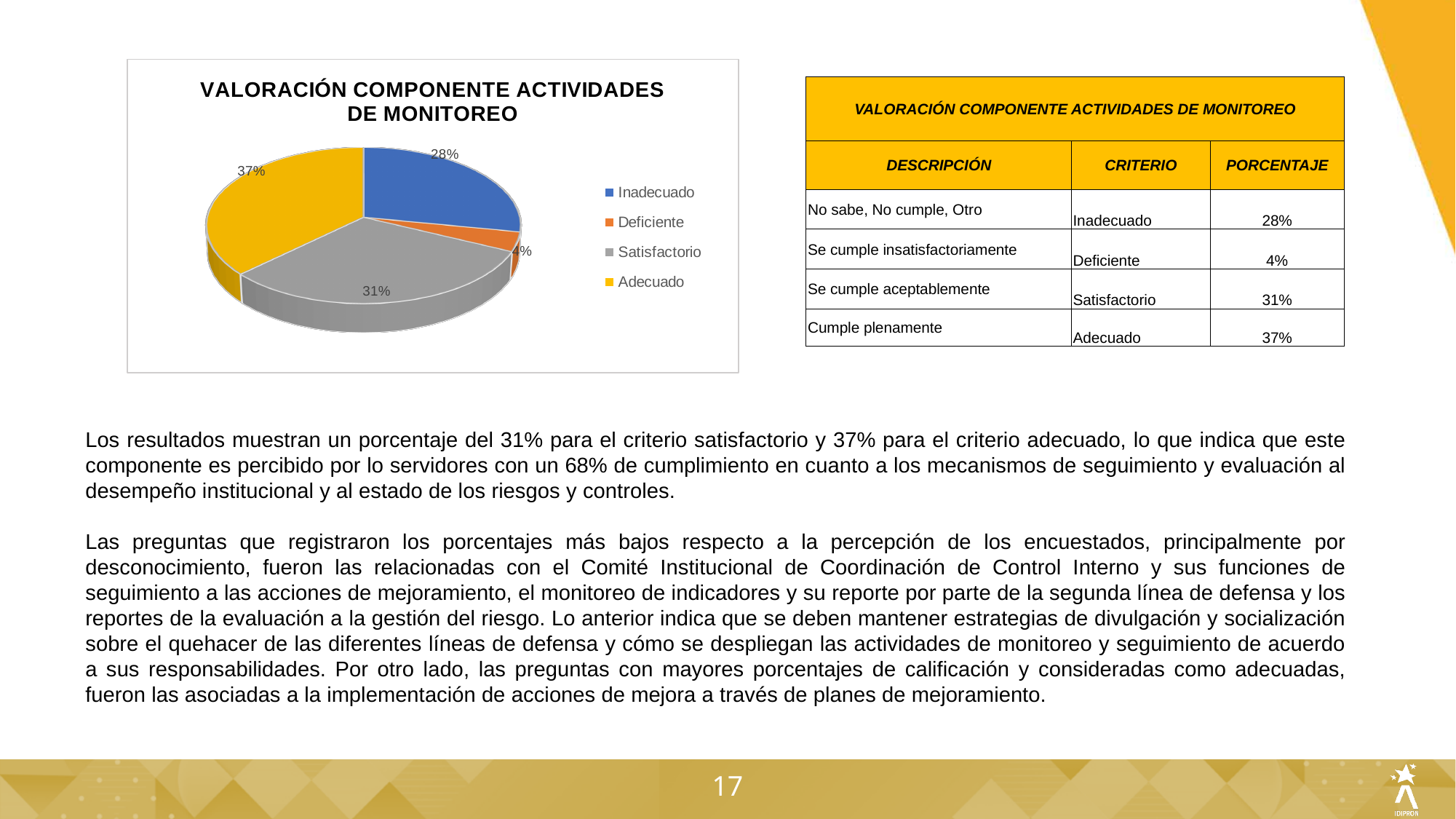
What percentage does the Deficiente slice represent? 4% Which category has the smallest share of the pie? Deficiente How many categories does the pie chart show? 4 What percentage does the Inadecuado slice represent? 28% What percentage does the Adecuado slice represent? 37% What is the difference in percentage points between Adecuado and Satisfactorio? 6 What percentage does the Satisfactorio slice represent? 31% What type of chart is shown on the slide? Pie chart Which is larger, the Inadecuado slice or the Satisfactorio slice? Satisfactorio Which category has the largest share of the pie? Adecuado What colour is the Adecuado slice in the pie chart? Yellow What is the title of the chart? VALORACIÓN COMPONENTE ACTIVIDADES DE MONITOREO